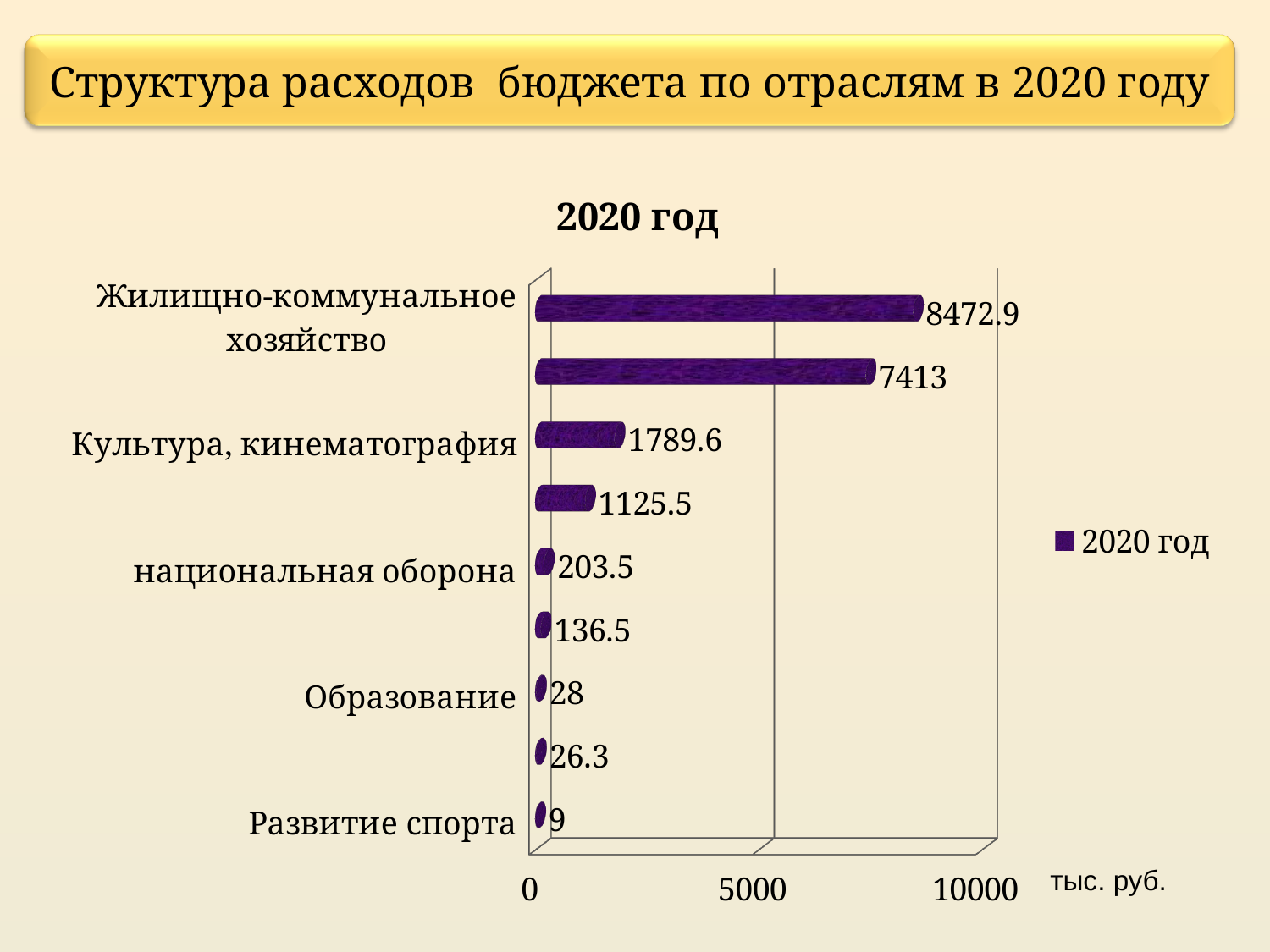
How many bars are plotted in the chart? 9 What is the value for Культура, кинематография? 1789.6 Which is larger, the value for национальная оборона or the value for Образование? национальная оборона Is the value for Жилищно-коммунальное хозяйство greater or less than 5000? greater What is the value for Жилищно-коммунальное хозяйство? 8472.9 What is the difference between the values for Жилищно-коммунальное хозяйство and Культура, кинематография? 6683.3 What is the value for национальная оборона? 203.5 Which category has the lowest value? Развитие спорта Which category has the highest value? Жилищно-коммунальное хозяйство What kind of chart is shown on the slide? bar chart What is the value for Развитие спорта? 9 What is the value for Образование? 28